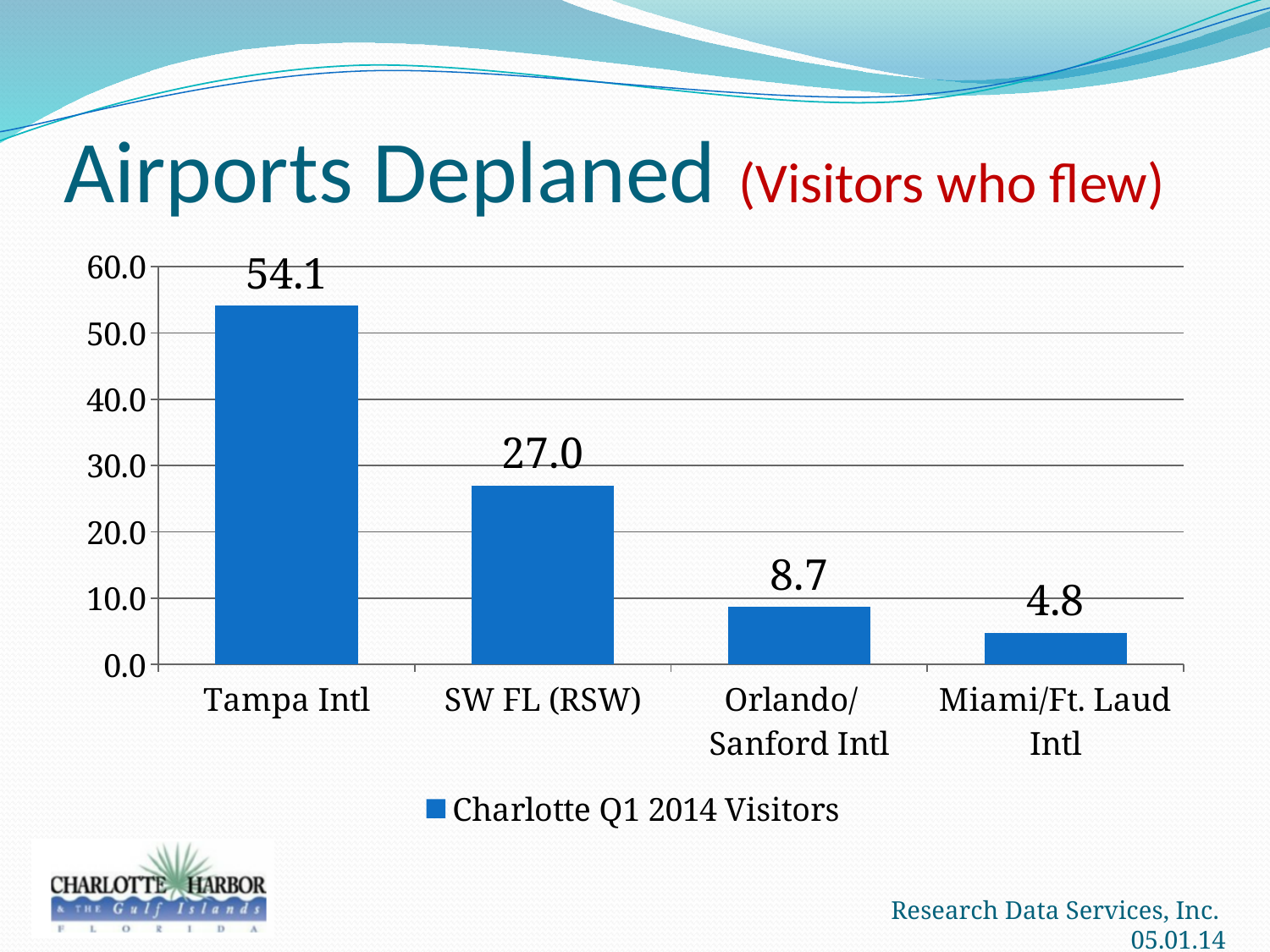
Which airport has the lowest value? Miami/Ft. Laud Intl What is the difference between the values for Tampa Intl and SW FL (RSW)? 27.1 What is the value for Orlando/Sanford Intl? 8.7 What is the value for Tampa Intl? 54.1 What is the value for Miami/Ft. Laud Intl? 4.8 Which airport has the highest value? Tampa Intl Which is larger, the value for Orlando/Sanford Intl or Miami/Ft. Laud Intl? Orlando/Sanford Intl What series does the legend list? Charlotte Q1 2014 Visitors What kind of chart is shown on the slide? bar chart What is the value for SW FL (RSW)? 27.0 How many airports are shown on the chart? 4 Is the value for SW FL (RSW) greater or less than 30.0? less